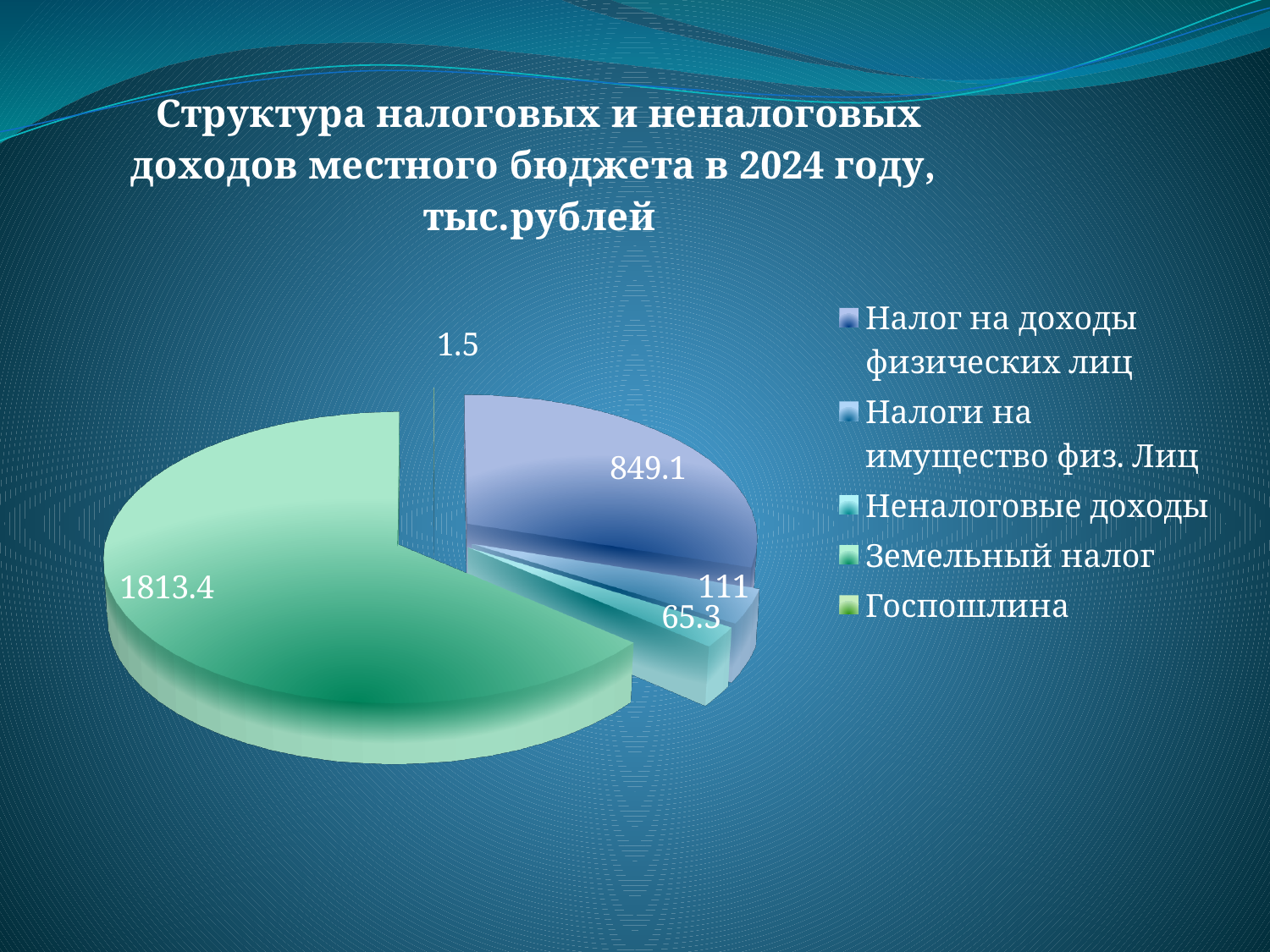
What is the value for Госпошлина? 1.5 What type of chart is shown on the slide? Pie chart How many categories does the pie chart have? 5 What is the value for Земельный налог? 1813.4 Which is larger, Налоги на имущество физ. Лиц or Неналоговые доходы? Налоги на имущество физ. Лиц Which category has the largest share of the pie? Земельный налог What is the value for Налоги на имущество физ. Лиц? 111 Which category has the smallest share of the pie? Госпошлина What is the value for Налог на доходы физических лиц? 849.1 What is the title of the chart? Структура налоговых и неналоговых доходов местного бюджета в 2024 году, тыс.рублей What is the value for Неналоговые доходы? 65.3 What is the difference between Земельный налог and Налог на доходы физических лиц? 964.3